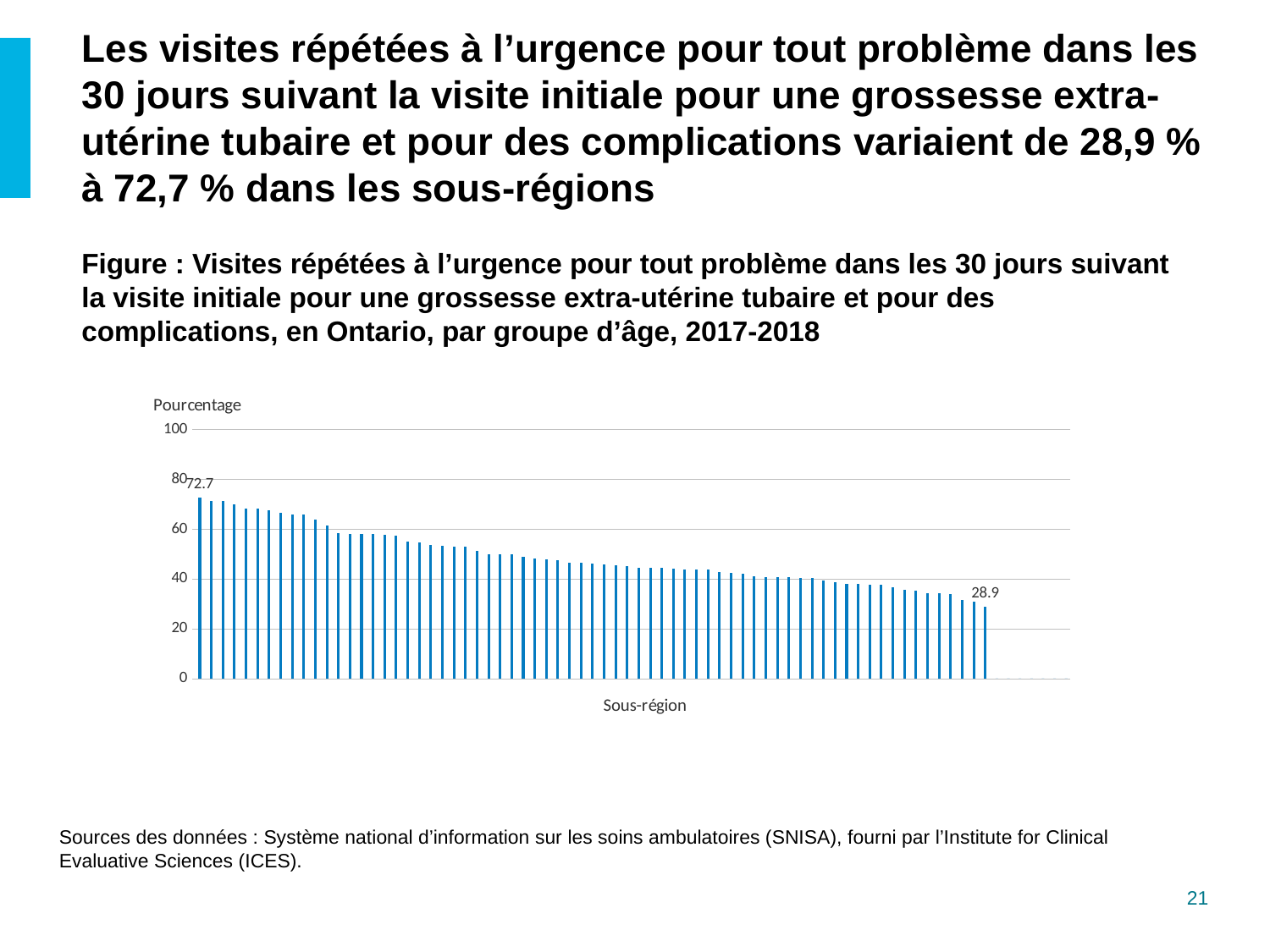
Do the bar values rise or fall from left to right along the x axis? fall Is the value of the rightmost bar greater or less than 40? less What is the label of the vertical axis of the chart? Pourcentage Is the value of the leftmost bar greater or less than 60? greater What is the difference between the highest value (72.7) and the lowest value (28.9) in the chart? 43.8 What is the lowest value shown in the chart? 28.9 What is the value of the rightmost (last) bar in the chart? 28.9 Which is larger, the value of the leftmost bar or the value of the rightmost bar? the leftmost bar What kind of chart is shown on the slide? bar chart What is the label of the horizontal axis of the chart? Sous-région What is the value of the leftmost (first) bar in the chart? 72.7 What is the highest value shown in the chart? 72.7